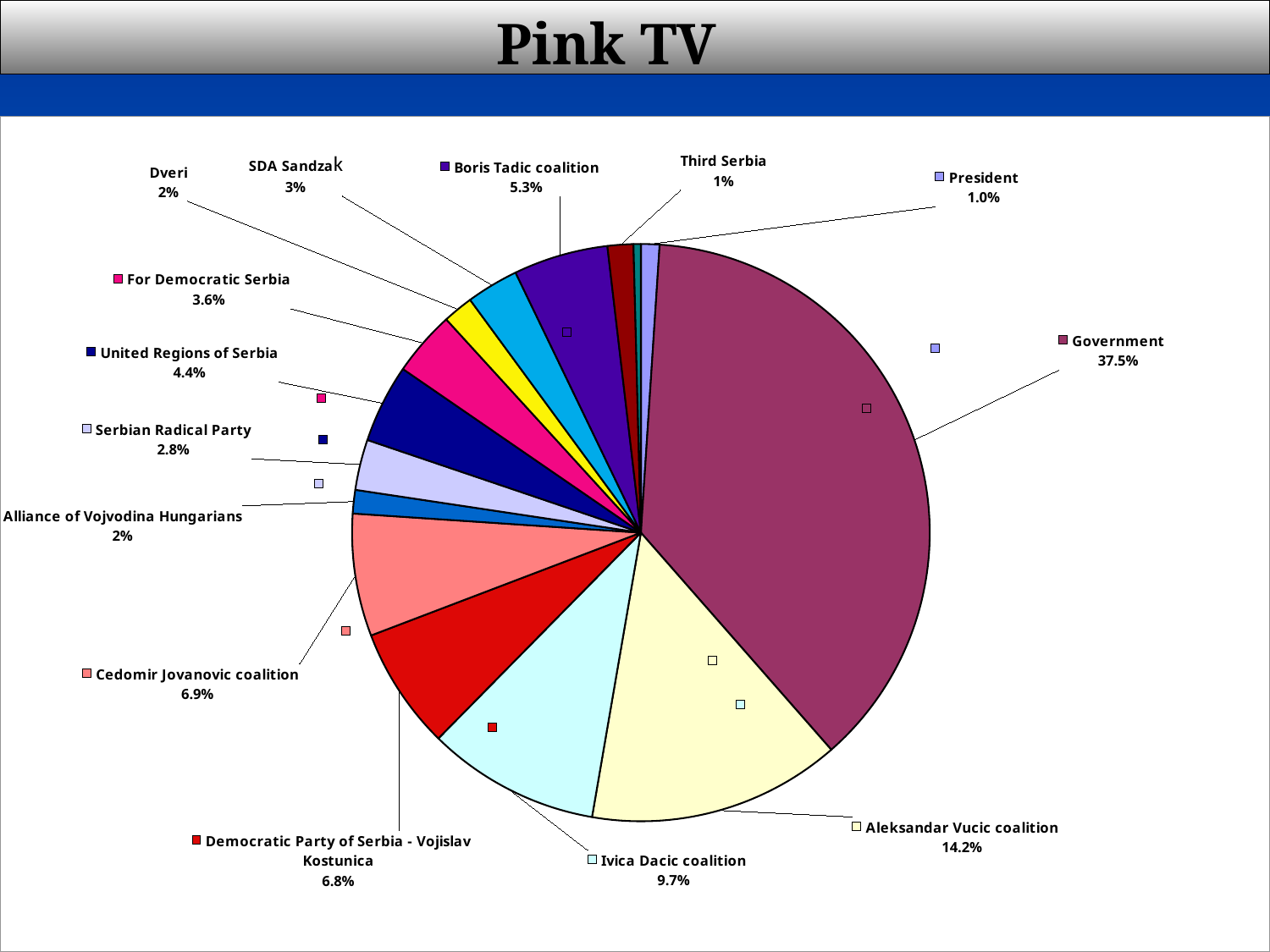
What is the value for Ivica Dacic coalition? 9.7% What kind of chart is shown on the slide? pie chart What is the value for United Regions of Serbia? 4.4% Which category has the largest slice of the pie? Government What is the value for Aleksandar Vucic coalition? 14.2% What is the value for Boris Tadic coalition? 5.3% What is the difference between the Ivica Dacic coalition share and the Boris Tadic coalition share? 4.4% What is the difference between the Government share and the Aleksandar Vucic coalition share? 23.3% What share of the pie does Government have? 37.5% Which is larger, Cedomir Jovanovic coalition or Democratic Party of Serbia - Vojislav Kostunica? Cedomir Jovanovic coalition What is the title of the slide? Pink TV